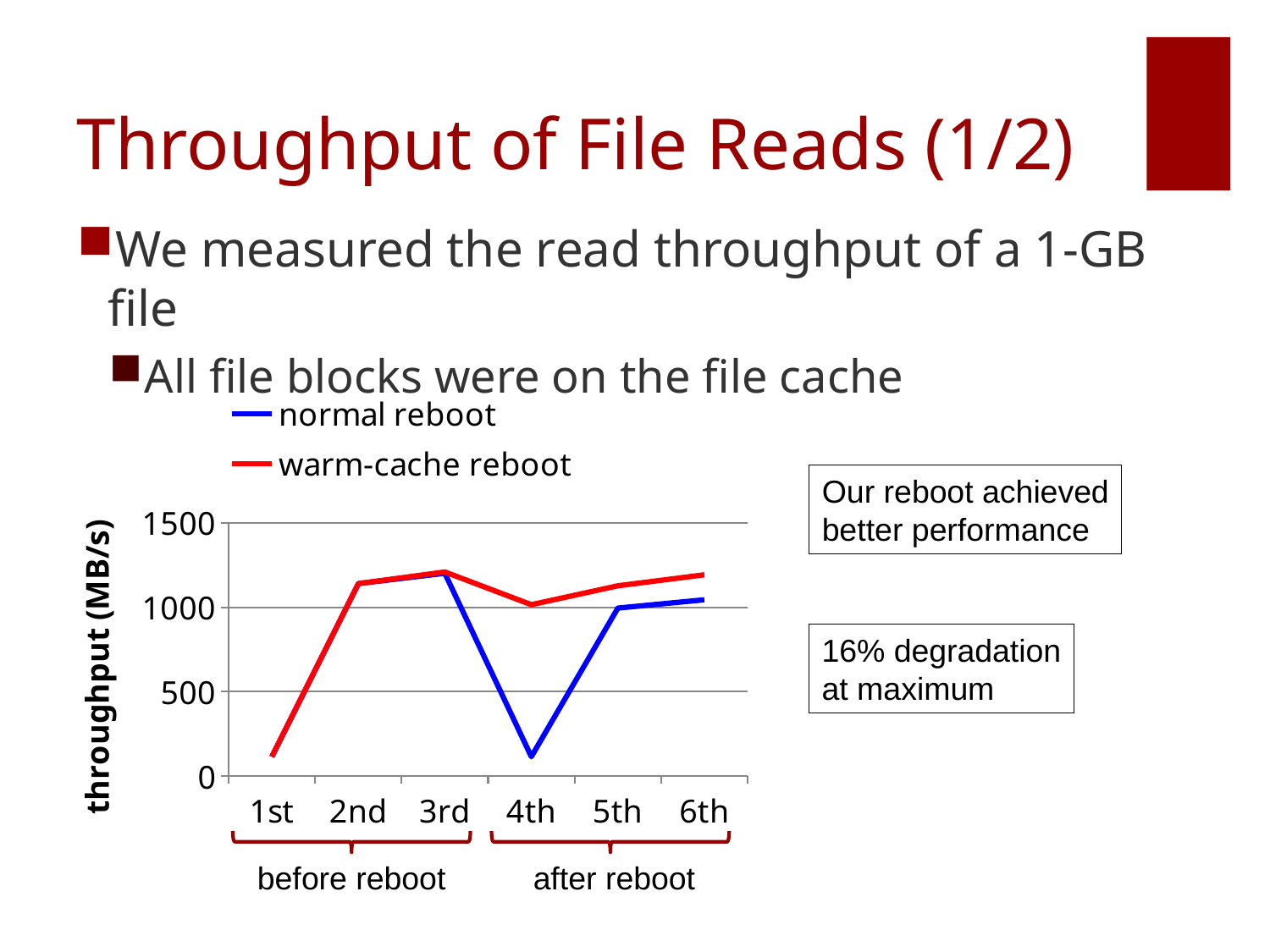
At the 4th measurement, which series has the higher throughput, normal reboot or warm-cache reboot? warm-cache reboot How many points are plotted along the x axis for each series? 6 Which series is drawn in red? warm-cache reboot At the 6th measurement, which series has the higher throughput, normal reboot or warm-cache reboot? warm-cache reboot Is the value for normal reboot at the 2nd measurement greater or less than 1000? greater What is the label of the y axis? throughput (MB/s) Is the value for normal reboot at the 4th measurement greater or less than 500? less What kind of chart is shown on the slide? line chart How many series does the chart's legend list? 2 Does the normal reboot series rise or fall from the 3rd to the 4th measurement? fall Is the value for warm-cache reboot at the 4th measurement greater or less than 500? greater